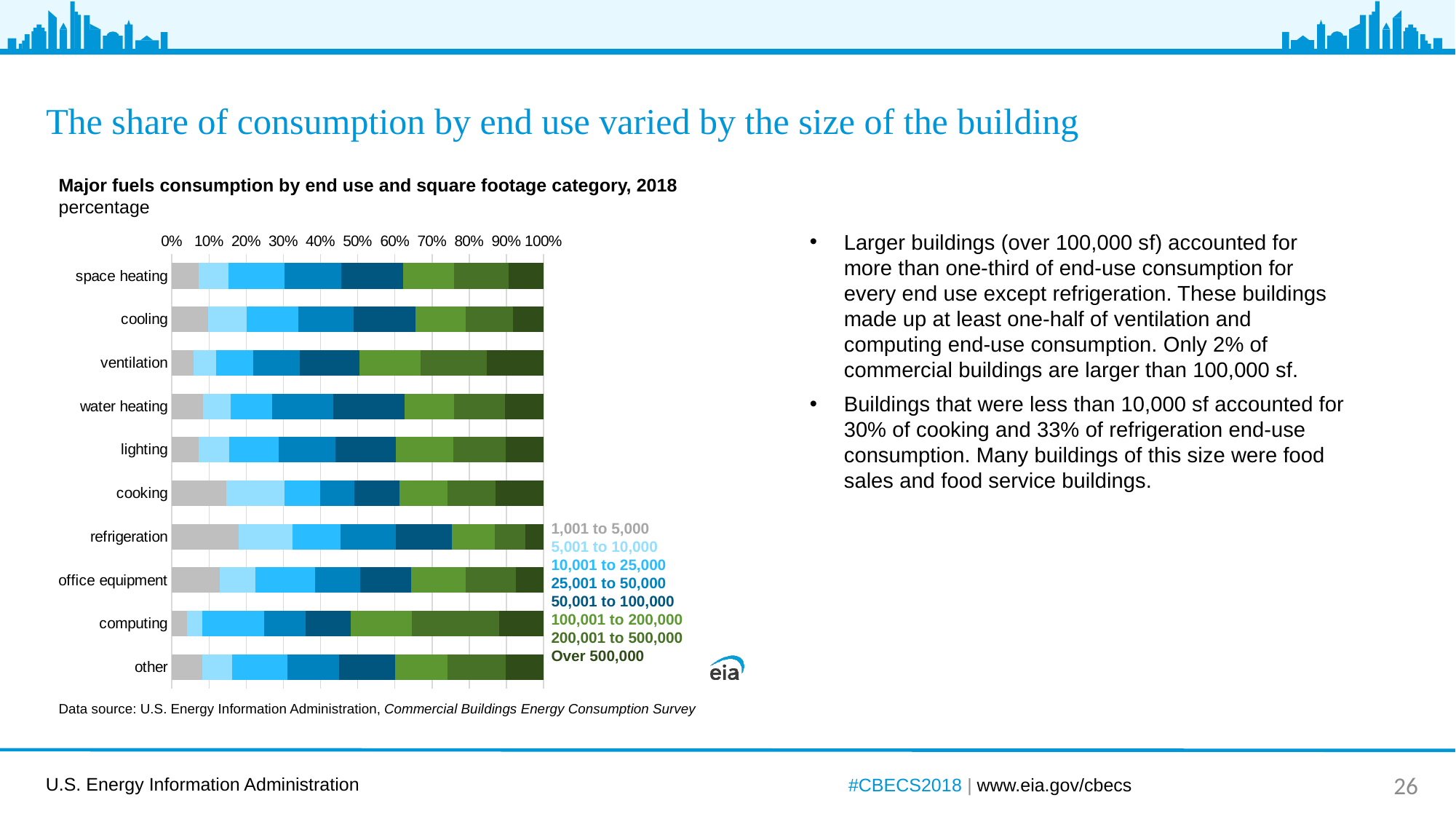
Is the share of refrigeration consumption from buildings over 500,000 square feet greater or less than 10%? less Which has a larger share from buildings over 500,000 square feet: computing or refrigeration? computing What is the title of the chart? Major fuels consumption by end use and square footage category, 2018 How many square footage categories does the legend list? 8 Which has a larger share from buildings of 1,001 to 5,000 square feet: refrigeration or ventilation? refrigeration Is the share of refrigeration consumption from buildings of 1,001 to 5,000 square feet greater or less than 10%? greater Which square footage category is listed first in the legend? 1,001 to 5,000 How many end-use categories are plotted on the chart? 10 What is the highest value shown on the percentage axis? 100% Is the share of ventilation consumption from buildings of 1,001 to 5,000 square feet greater or less than 10%? less What kind of chart is shown on the slide? stacked bar chart